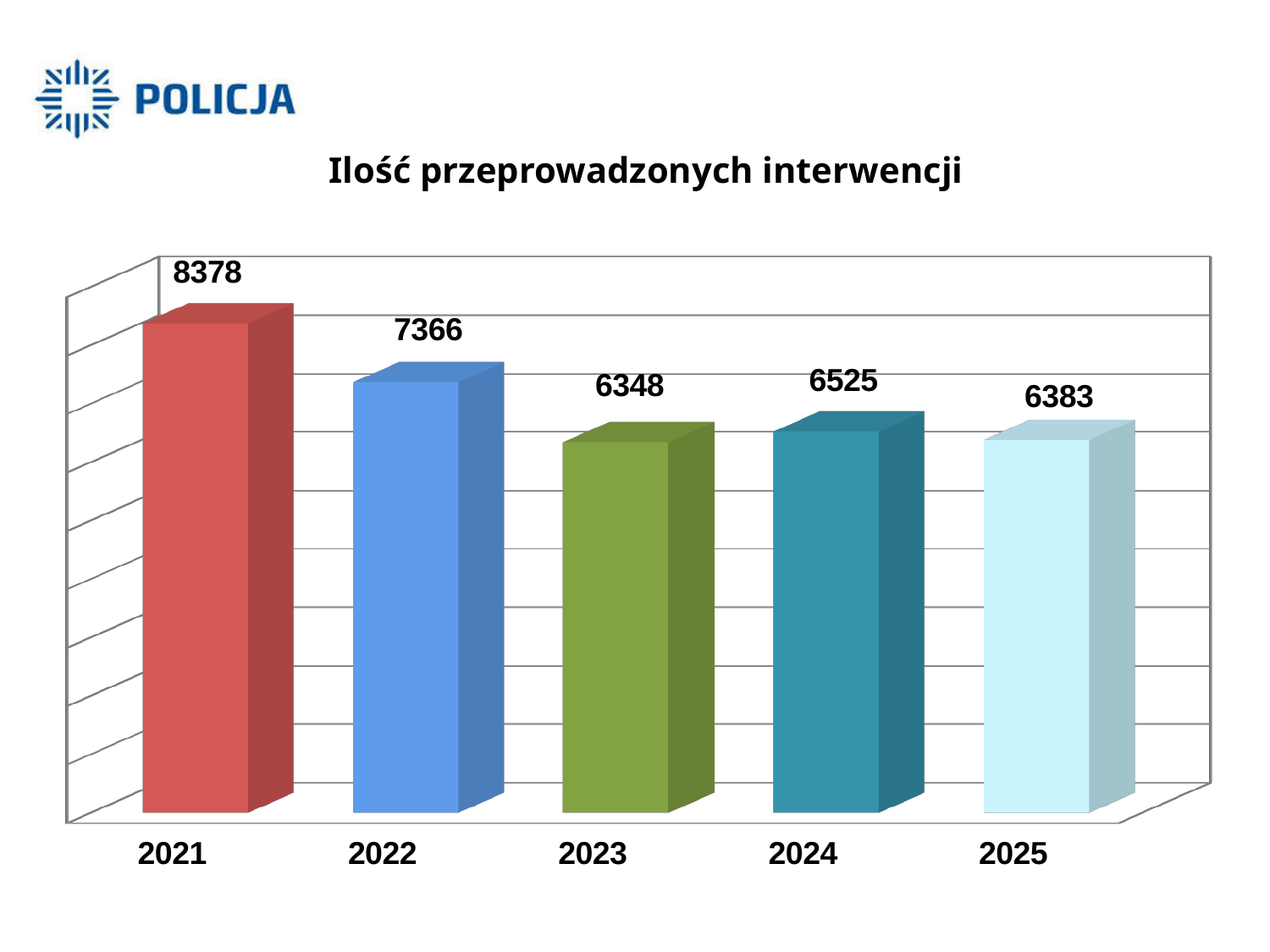
Which year has the highest value? 2021 What is the difference between the values for 2021 and 2022? 1012 What is the title of the chart? Ilość przeprowadzonych interwencji What is the difference between the values for 2024 and 2023? 177 What is the value for 2021? 8378 What is the value for 2023? 6348 Do the values rise or fall from 2021 to 2023? fall Which year has the lowest value? 2023 What is the value for 2025? 6383 How many years are shown on the chart? 5 What kind of chart is this? bar chart Which is larger, the value for 2022 or the value for 2024? 2022